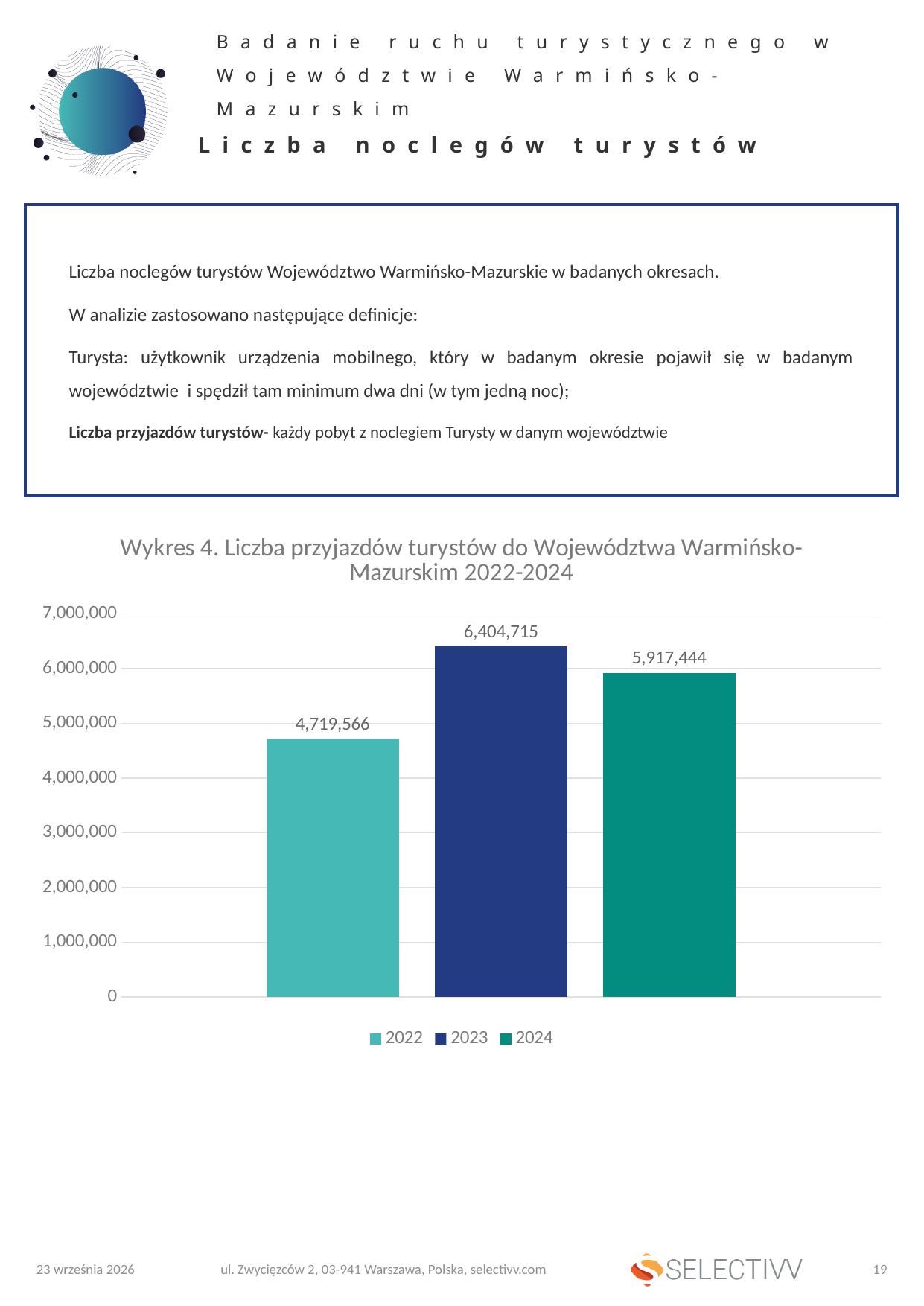
Is the value for 2024 greater or less than 6,000,000? less Which is larger, the value for 2024 or the value for 2022? 2024 What is the difference between the values for 2023 and 2022? 1,685,149 What is the value for 2024 in the chart? 5,917,444 How many entries does the chart legend list? 3 What is the value for 2022 in the chart 'Wykres 4. Liczba przyjazdów turystów do Województwa Warmińsko-Mazurskim 2022-2024'? 4,719,566 Which year has the highest value in the chart? 2023 What is the difference between the values for 2023 and 2024? 487,271 How many bars are plotted in the chart? 3 What kind of chart is shown on the slide? bar chart What is the value for 2023 in the chart? 6,404,715 Which year has the lowest value in the chart? 2022